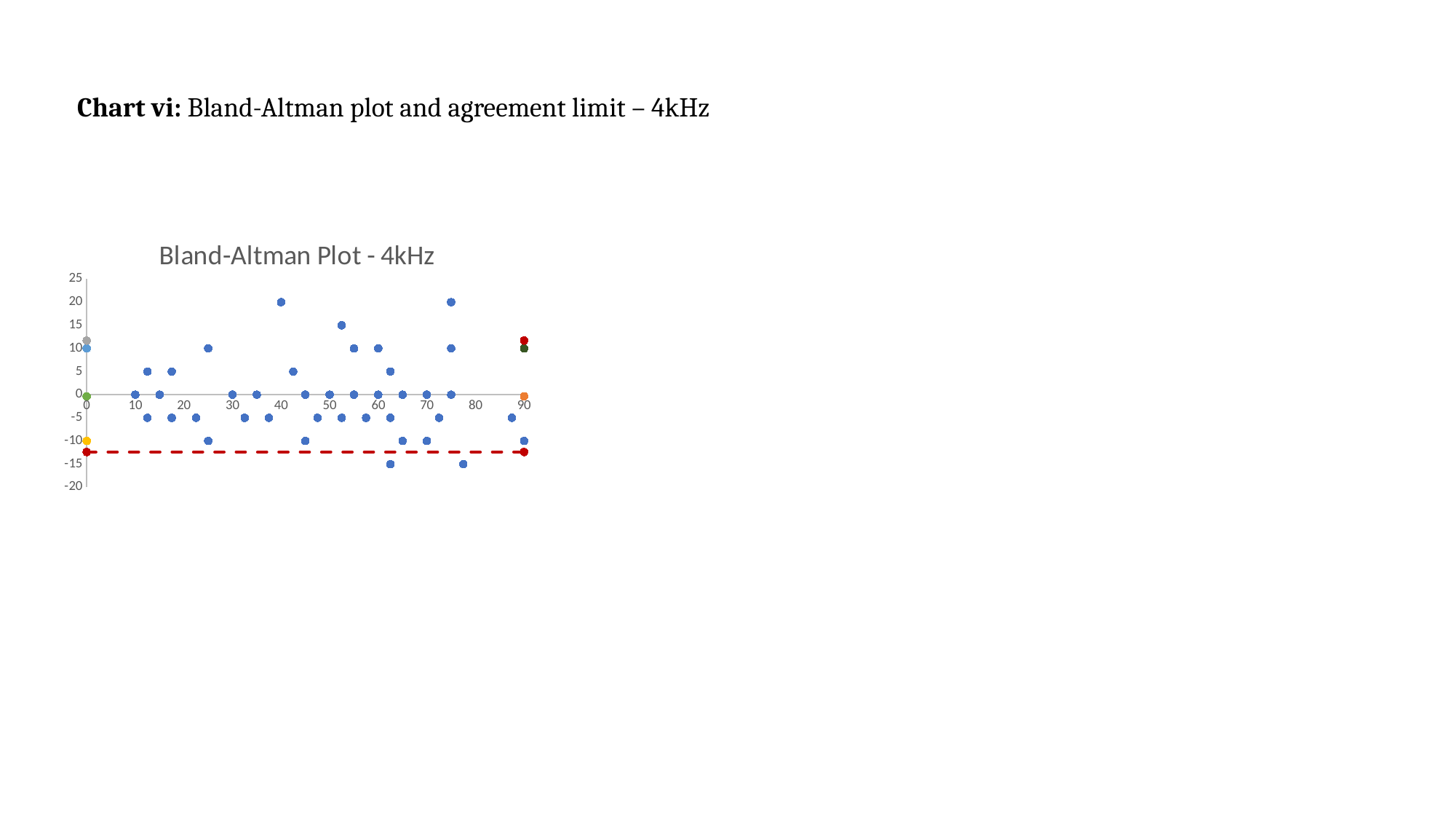
Is the highest plotted point greater or less than 15? greater Is the lowest plotted point greater or less than -10? less What is the lowest y value reached by any plotted point? -15 What is the largest value labelled on the y axis? 25 Is the dashed horizontal line drawn at a value greater or less than -10? less What kind of chart is shown on the slide? scatter plot What is the title of the chart? Bland-Altman Plot - 4kHz What is the largest value labelled on the x axis? 90 What colour is the dashed horizontal line on the chart? red What is the highest y value reached by any plotted point? 20 What is the smallest value labelled on the y axis? -20